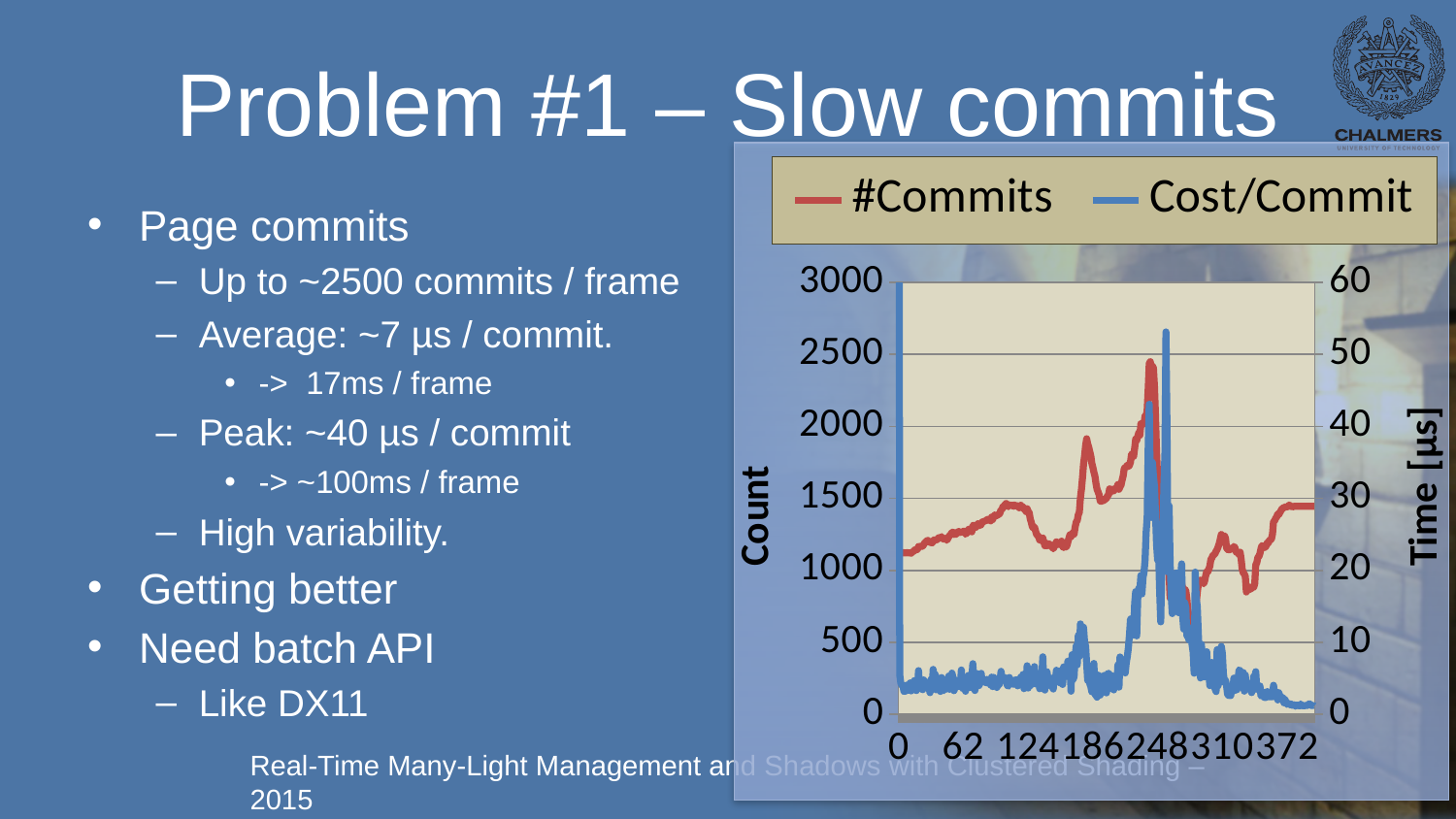
What is the last tick label shown on the x axis of the chart? 372 Is the peak value of the #Commits series greater or less than 2000? greater Is the peak value of the Cost/Commit series greater or less than 40? greater How many series does the chart's legend list? 2 What is the highest tick value shown on the left vertical axis (Count)? 3000 What is the highest tick value shown on the right vertical axis (Time [µs])? 60 What are the two series named in the chart's legend? #Commits and Cost/Commit Which series reaches its peak on the chart at a higher position relative to its own axis, #Commits (left axis, max 3000) or Cost/Commit (right axis, max 60)? Cost/Commit What is the title of the left vertical axis of the chart? Count What kind of chart is shown on the slide? line chart Is the value of the Cost/Commit series at the far right end of the x axis greater or less than 10? less